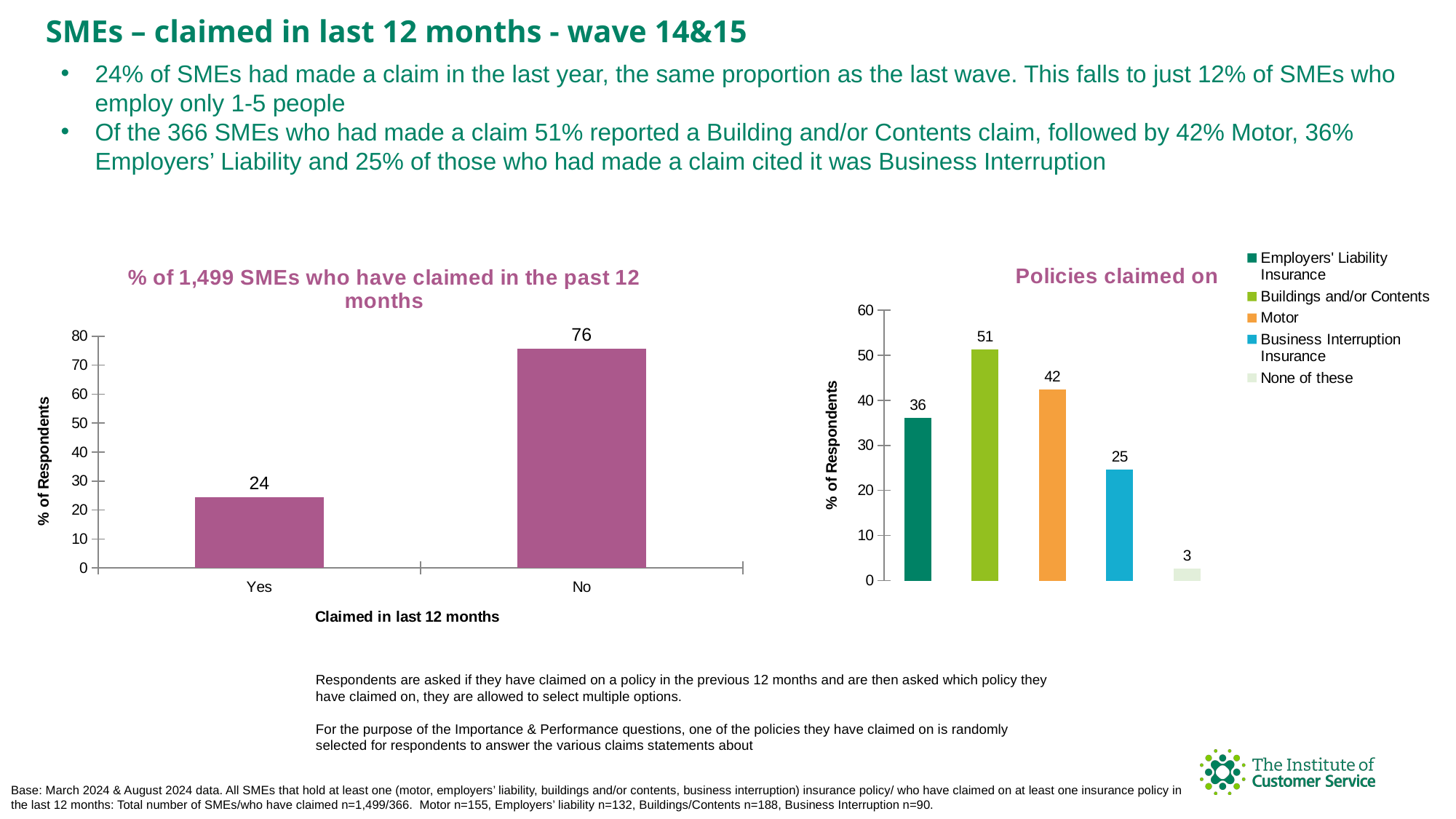
In the 'Policies claimed on' chart, what is the value for Business Interruption Insurance? 25 What type of chart is the 'Policies claimed on' chart? Bar chart In the 'Policies claimed on' chart, what is the value for Motor? 42 In the '% of 1,499 SMEs who have claimed in the past 12 months' chart, what is the difference between the 'No' and 'Yes' values? 52 In the '% of 1,499 SMEs who have claimed in the past 12 months' chart, how many categories are shown on the x axis? 2 In the '% of 1,499 SMEs who have claimed in the past 12 months' chart, what is the value for 'Yes'? 24 In the 'Policies claimed on' chart, which category has the lowest value? None of these In the 'Policies claimed on' chart, which is larger: Employers' Liability Insurance or Motor? Motor In the 'Policies claimed on' chart, what is the difference between Buildings and/or Contents and Employers' Liability Insurance? 15 In the 'Policies claimed on' chart, how many entries does the legend list? 5 In the '% of 1,499 SMEs who have claimed in the past 12 months' chart, what is the value for 'No'? 76 In the 'Policies claimed on' chart, which policy has the highest value? Buildings and/or Contents